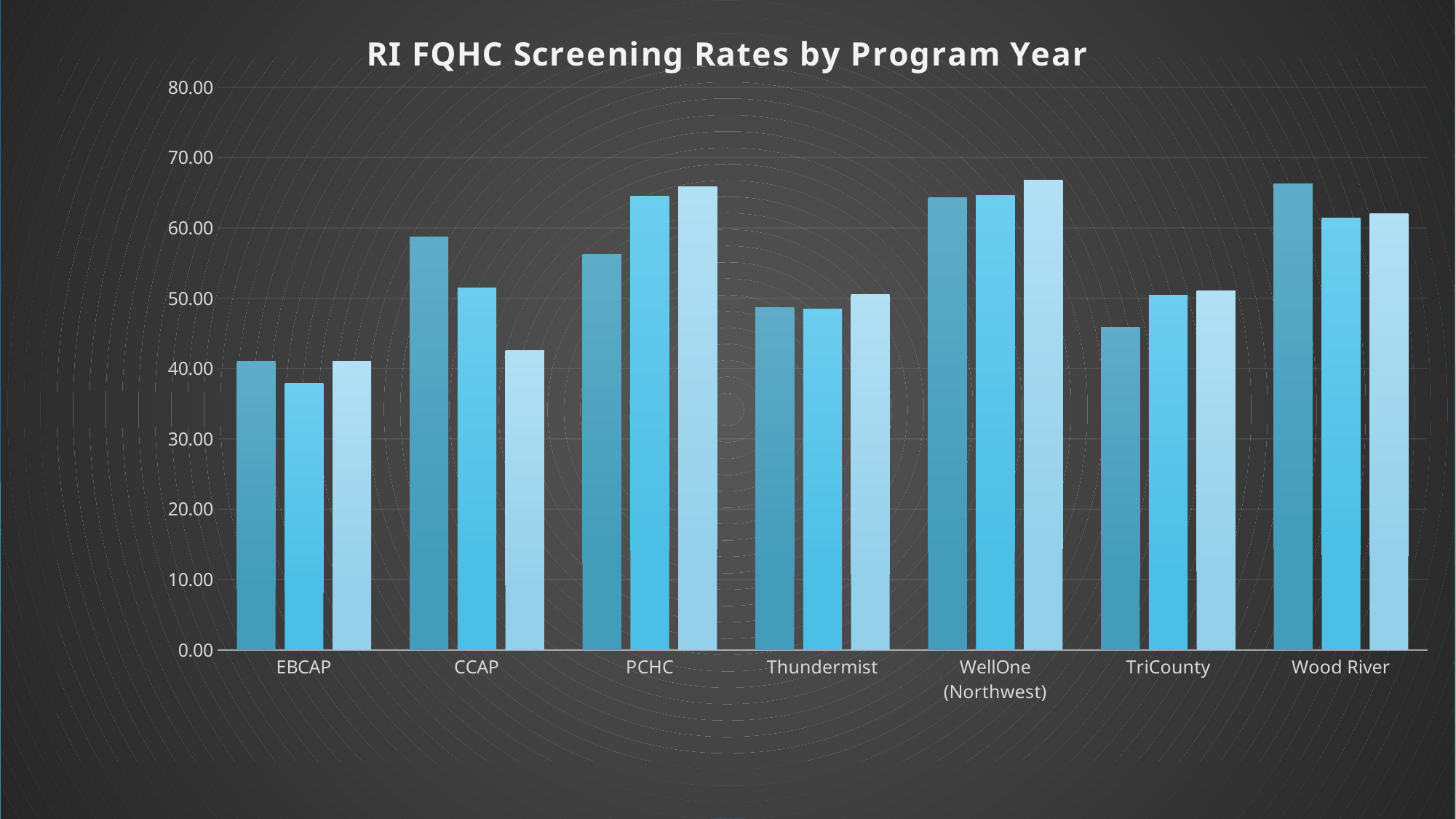
Which category has the lowest screening rates overall? EBCAP Is the value of the middle bar for EBCAP greater or less than 40? less How many categories (health centers) are shown on the x axis? 7 What kind of chart is shown on the slide? bar chart Do the three bars for CCAP rise or fall from left to right? fall Is the value of the first bar for TriCounty greater or less than 50? less What is the title of the chart? RI FQHC Screening Rates by Program Year Is the value of the first bar for CCAP greater or less than 50? greater How many bars are plotted for each category? 3 For CCAP, which is larger: the first bar or the third bar? the first bar